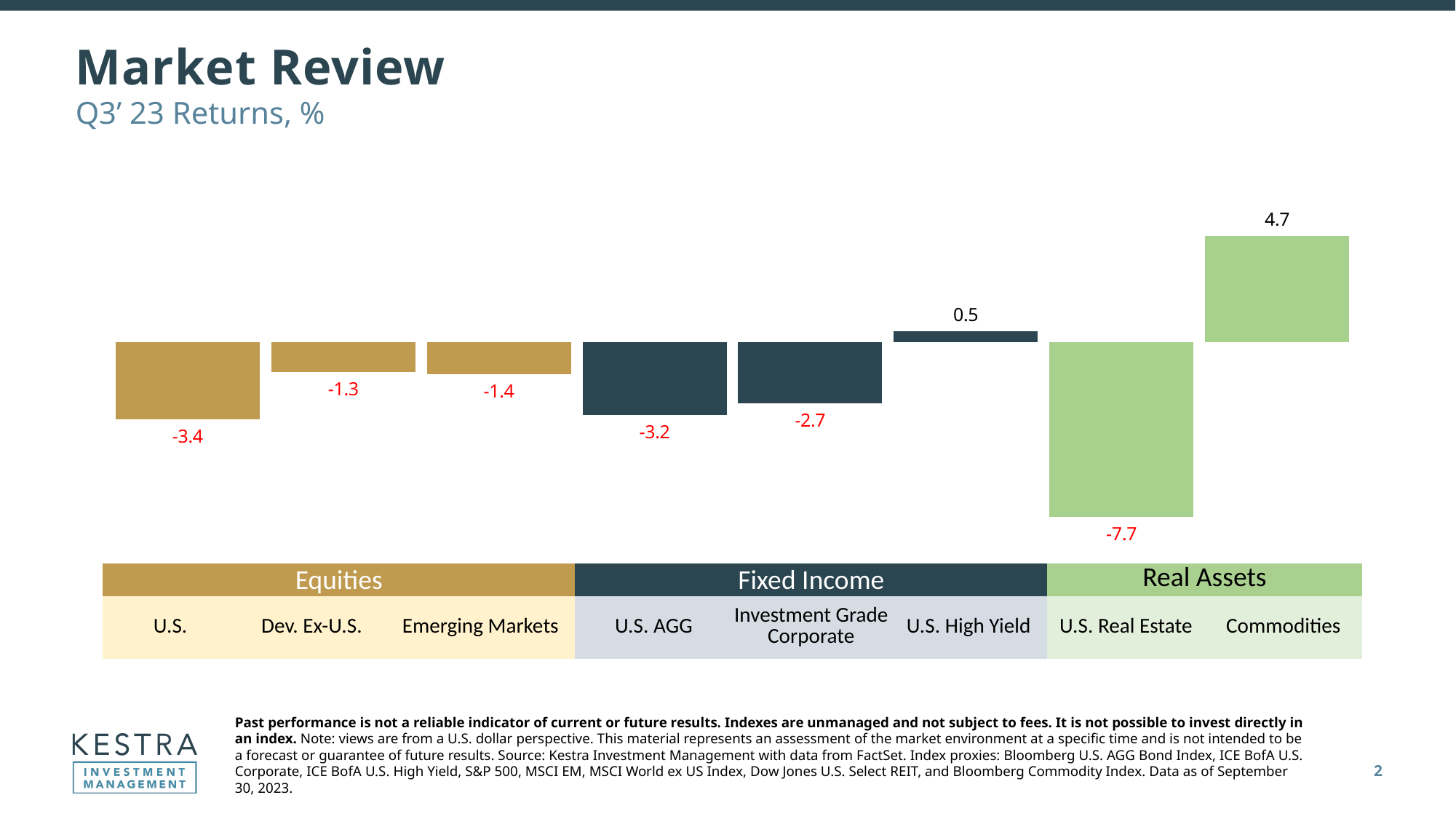
What is the difference between the returns for Commodities and U.S. Real Estate? 12.4 Which category has the highest Q3' 23 return? Commodities Which has the larger return, U.S. AGG or Investment Grade Corporate? Investment Grade Corporate What is the Q3' 23 return for Commodities? 4.7 What is the Q3' 23 return for U.S. AGG? -3.2 How many categories have a positive return? 2 How many categories are plotted in the chart? 8 Which category has the lowest Q3' 23 return? U.S. Real Estate What kind of chart is shown on the slide? Bar chart Which asset group do the gold-coloured bars represent? Equities What is the Q3' 23 return for U.S. Real Estate? -7.7 What is the Q3' 23 return for U.S. High Yield? 0.5